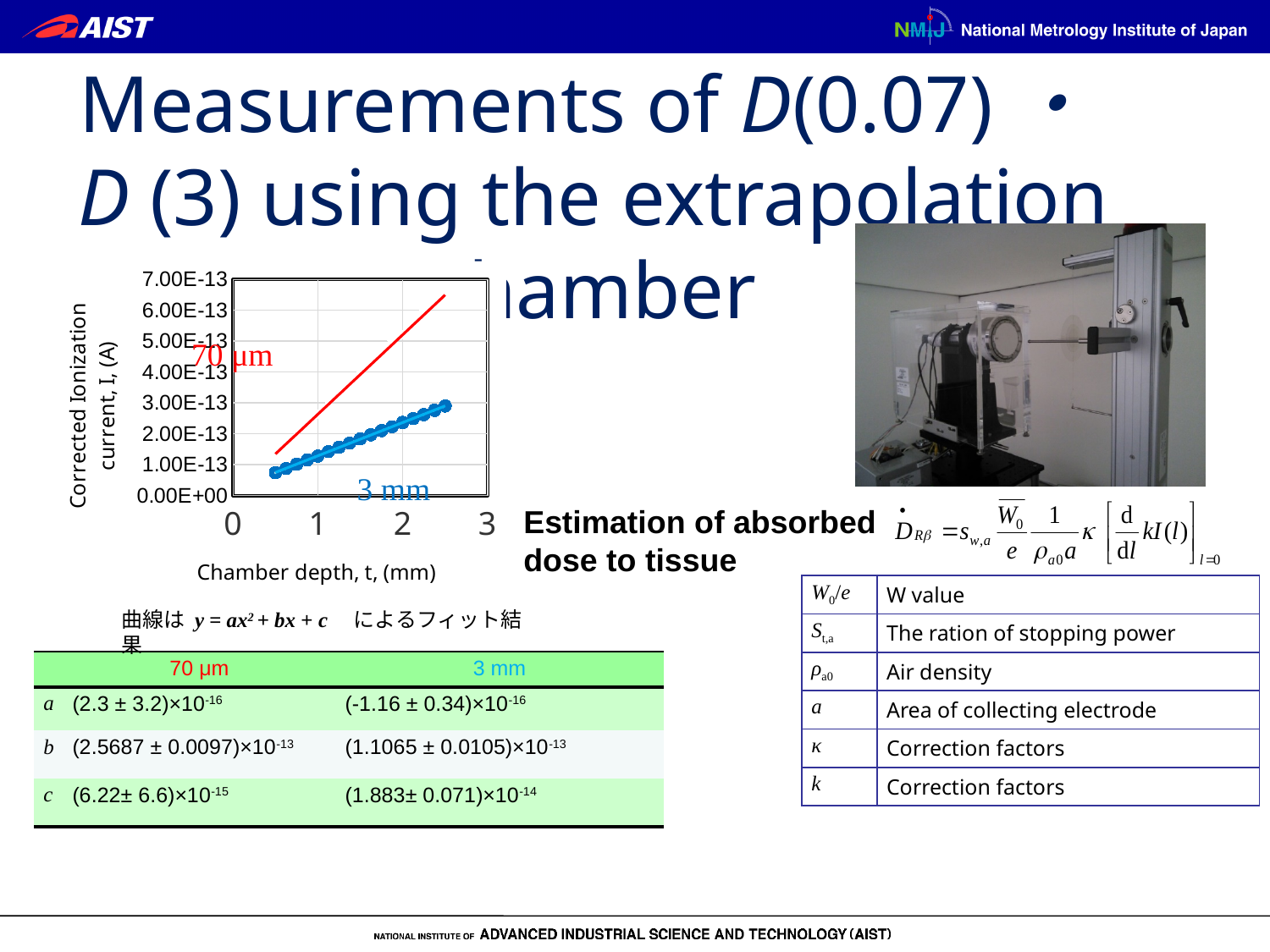
What kind of chart is shown on the slide? Scatter chart with lines Which series is drawn in red on the chart? 70 μm Does the corrected ionization current for the 3 mm series rise or fall as chamber depth increases? Rise Does the corrected ionization current for the 70 μm series rise or fall as chamber depth increases? Rise What is the title of the x axis of the chart? Chamber depth, t, (mm) Is the corrected ionization current for the 3 mm series at a chamber depth of 1 mm greater or less than 2.00E-13? less Is the corrected ionization current for the 3 mm series at a chamber depth of 2.5 mm greater or less than 4.00E-13? less How many data series are plotted on the chart? 2 At a chamber depth of 2 mm, which series has the higher corrected ionization current, 70 μm or 3 mm? 70 μm What is the title of the y axis of the chart? Corrected Ionization current, I, (A) Is the corrected ionization current for the 70 μm series at a chamber depth of 2.5 mm greater or less than 6.00E-13? greater